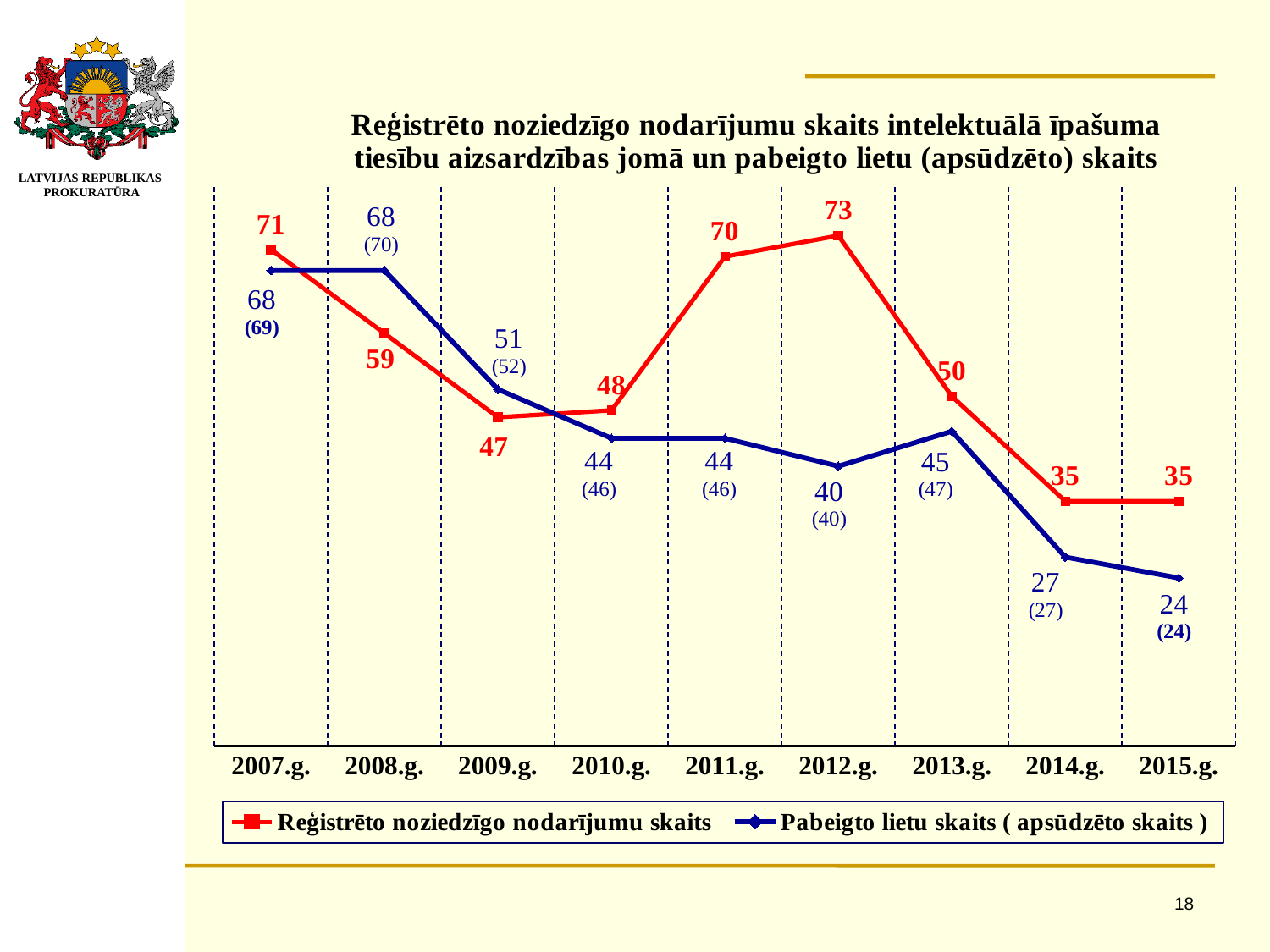
Does Reģistrēto noziedzīgo nodarījumu skaits rise or fall from 2012.g. to 2015.g.? Fall In which year is Reģistrēto noziedzīgo nodarījumu skaits highest? 2012.g. What is the value of Reģistrēto noziedzīgo nodarījumu skaits in 2012.g.? 73 What kind of chart is shown on the slide? Line chart How many years are shown on the x axis? 9 In which year is Pabeigto lietu skaits lowest? 2015.g. Which colour is used for the Pabeigto lietu skaits ( apsūdzēto skaits ) series? Blue What is the value of Pabeigto lietu skaits in 2015.g.? 24 What is the apsūdzēto skaits (value in parentheses) shown for 2009.g.? (52) Which is larger in 2011.g.: Reģistrēto noziedzīgo nodarījumu skaits or Pabeigto lietu skaits? Reģistrēto noziedzīgo nodarījumu skaits How many series does the legend list? 2 What is the difference between Reģistrēto noziedzīgo nodarījumu skaits in 2012.g. and 2013.g.? 23